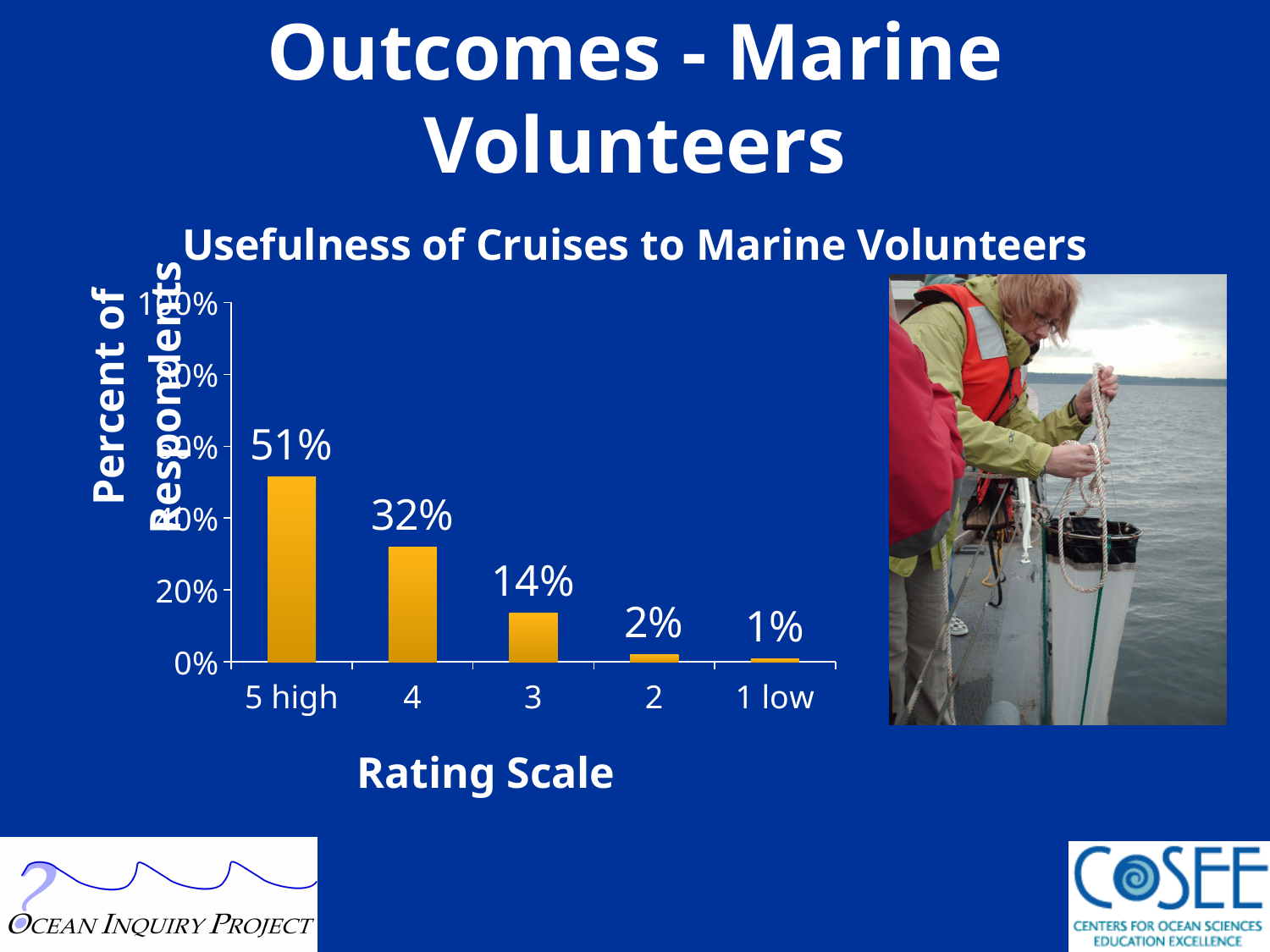
What percent of respondents gave a rating of 1 low? 1% Which rating category has the highest percent of respondents? 5 high Which rating category has the lowest percent of respondents? 1 low Which has a larger percent of respondents, rating 3 or rating 2? 3 What percent of respondents gave a rating of 4? 32% What is the title of the chart? Usefulness of Cruises to Marine Volunteers What percent of respondents gave a rating of 5 high? 51% How many rating categories are shown on the x axis? 5 What is the difference in percent of respondents between rating 5 high and rating 4? 19% What percent of respondents gave a rating of 3? 14% Is the value for rating 4 greater or less than 40%? less What kind of chart is shown on the slide? bar chart